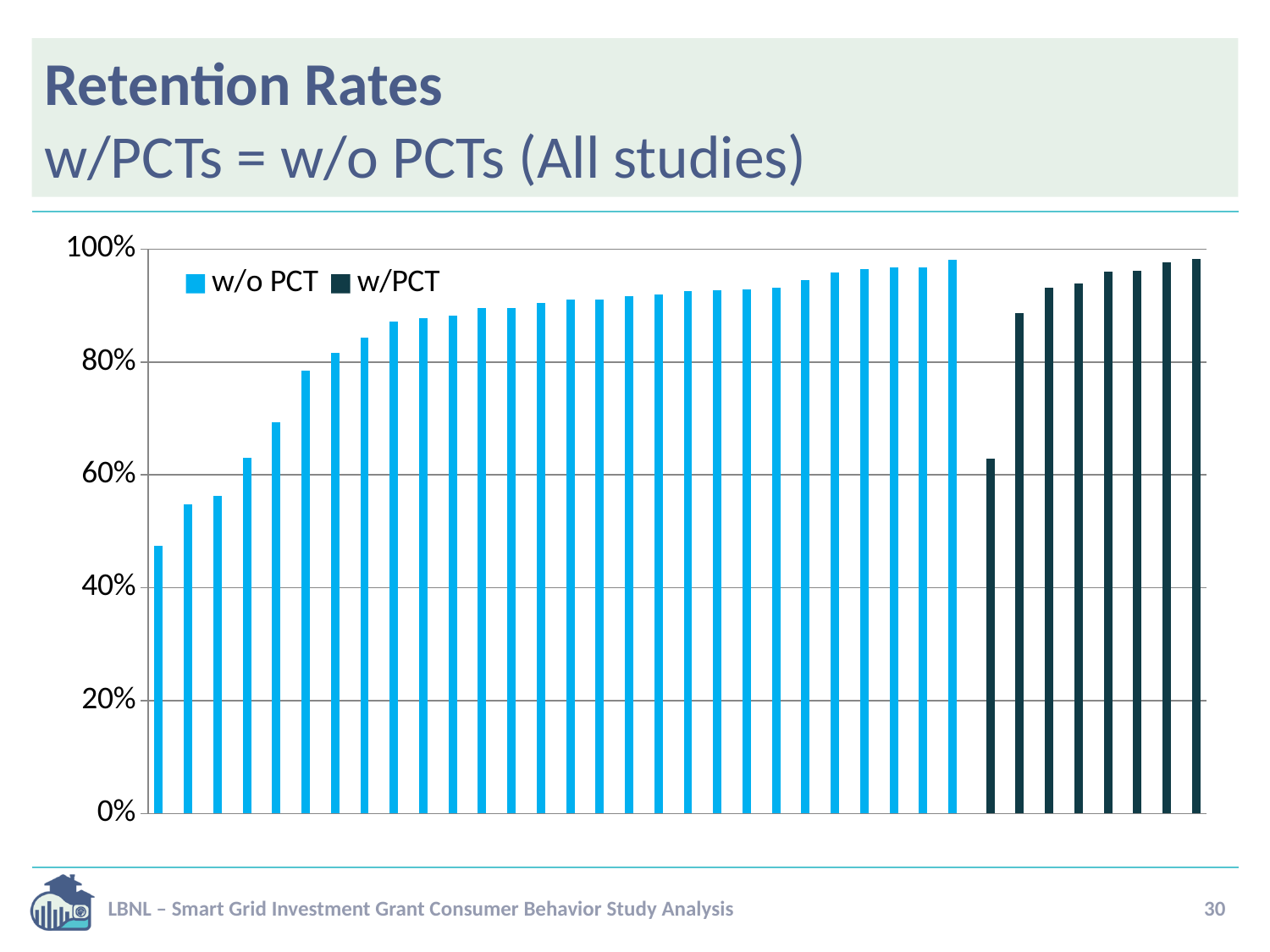
What kind of chart is shown on the slide? bar chart Is the value of the leftmost w/PCT bar greater or less than 80%? less Is the value of the rightmost w/PCT bar greater or less than 80%? greater Is the value of the leftmost w/o PCT bar greater or less than 40%? greater Which series is drawn in the dark navy colour? w/PCT Do the w/o PCT bars rise or fall from left to right? rise How many series does the legend list? 2 Which is larger: the leftmost w/o PCT bar or the leftmost w/PCT bar? the leftmost w/PCT bar Do the w/PCT bars rise or fall from left to right? rise What are the two series named in the legend? w/o PCT and w/PCT How many w/PCT (dark) bars are plotted? 8